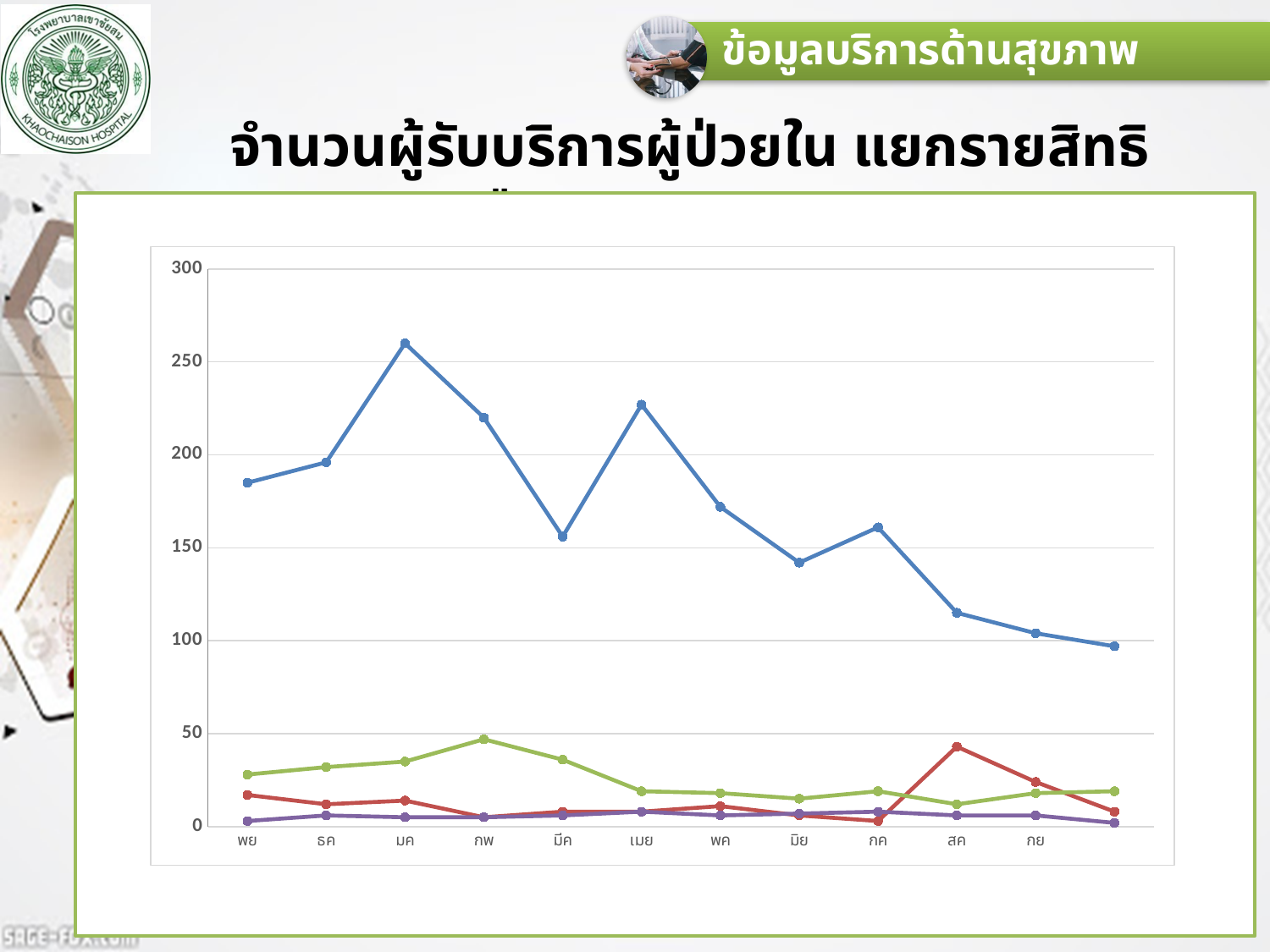
At which month does the red line reach its highest value? สค How many lines (data series) are plotted on the chart? 4 Is the value of the blue line at มค greater or less than 250? greater At which month does the blue line reach its highest value? มค Is the value of the blue line at มีค greater or less than 200? less Is the value of the green line at กพ greater or less than 50? less At which month does the green line reach its highest value? กพ At กพ, which line has the larger value: the green line or the red line? green What kind of chart is shown on the slide? line chart Does the blue line rise or fall from กค to the end of the chart? fall Which is larger for the blue line: the value at มค or the value at เมย? มค